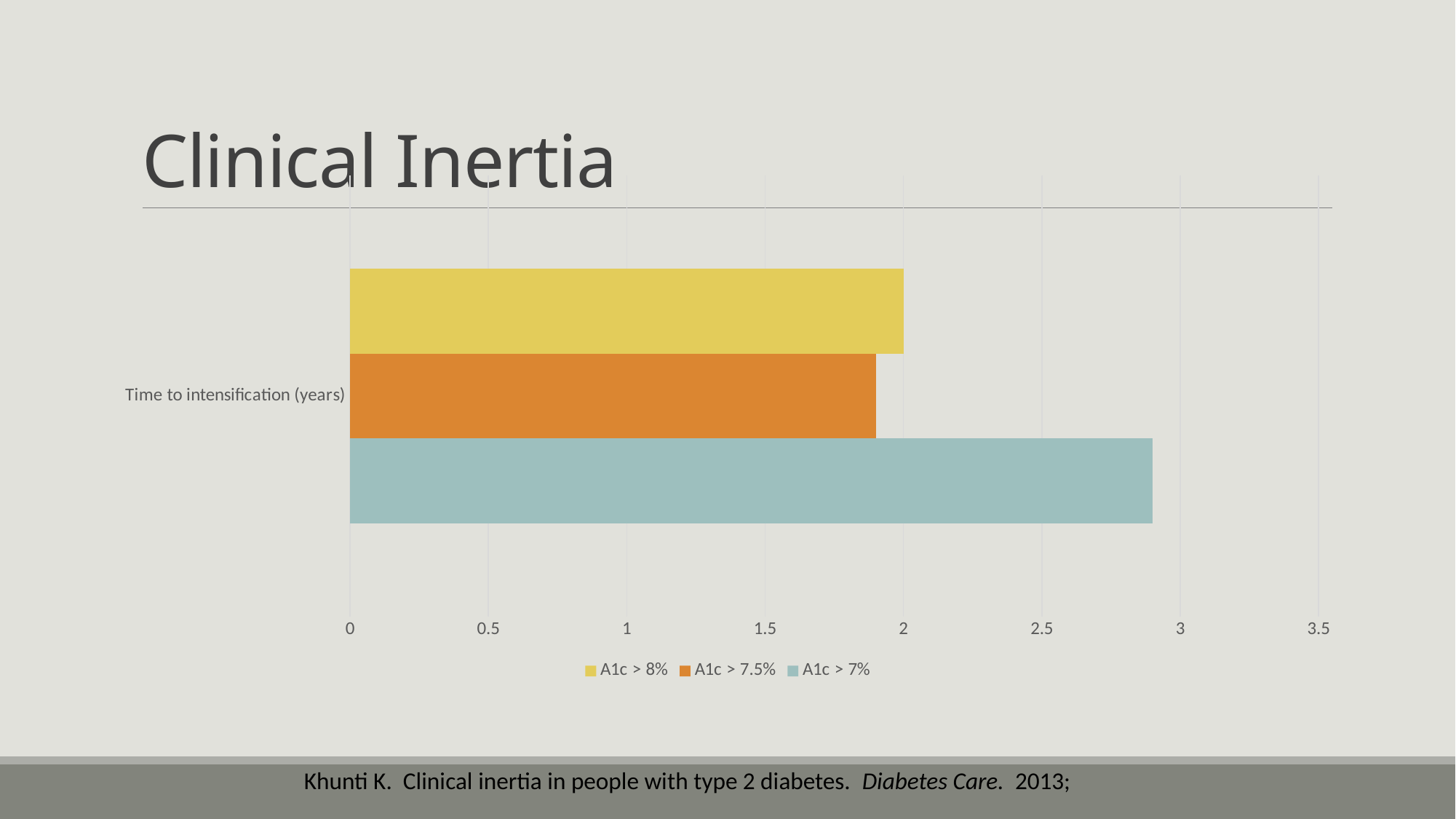
Which is larger, the time to intensification for A1c > 7% or for A1c > 8%? A1c > 7% Is the time to intensification for A1c > 7% greater or less than 2.5? greater What colour is the bar for the A1c > 7.5% series? orange Which is larger, the time to intensification for A1c > 7% or for A1c > 7.5%? A1c > 7% How many categories are plotted on the y axis? 1 What kind of chart is shown on the slide? bar chart Is the time to intensification for A1c > 7.5% greater or less than 1.5? greater What is the title of the slide containing the chart? Clinical Inertia How many series does the legend list? 3 Which series has the longest bar for Time to intensification (years)? A1c > 7% What is the time to intensification (years) for A1c > 8%? 2 Is the time to intensification for A1c > 7% greater or less than 3? less